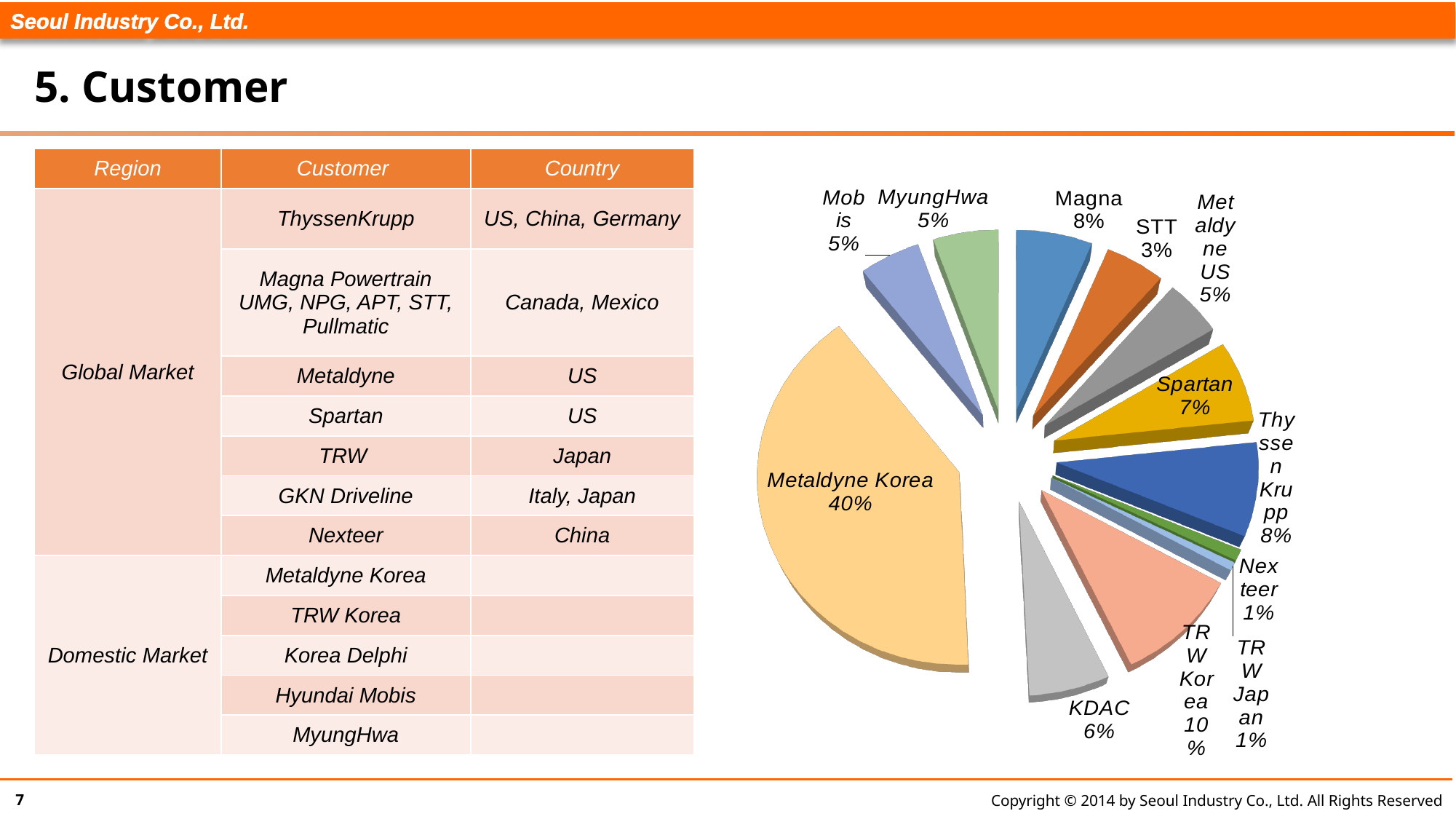
What is the value shown for STT? 3% What is the value shown for Spartan? 7% What is the difference between the shares of Metaldyne Korea and TRW Korea? 30% What is the value shown for TRW Korea? 10% How many slices does the pie chart have? 12 Which is larger, the share for Magna or the share for KDAC? Magna What is the value shown for ThyssenKrupp? 8% What share of the pie does Metaldyne Korea hold? 40% What is the difference between the shares of Spartan and STT? 4% What is the value shown for KDAC? 6% Which customer has the largest slice of the pie? Metaldyne Korea What kind of chart is shown on the slide? pie chart